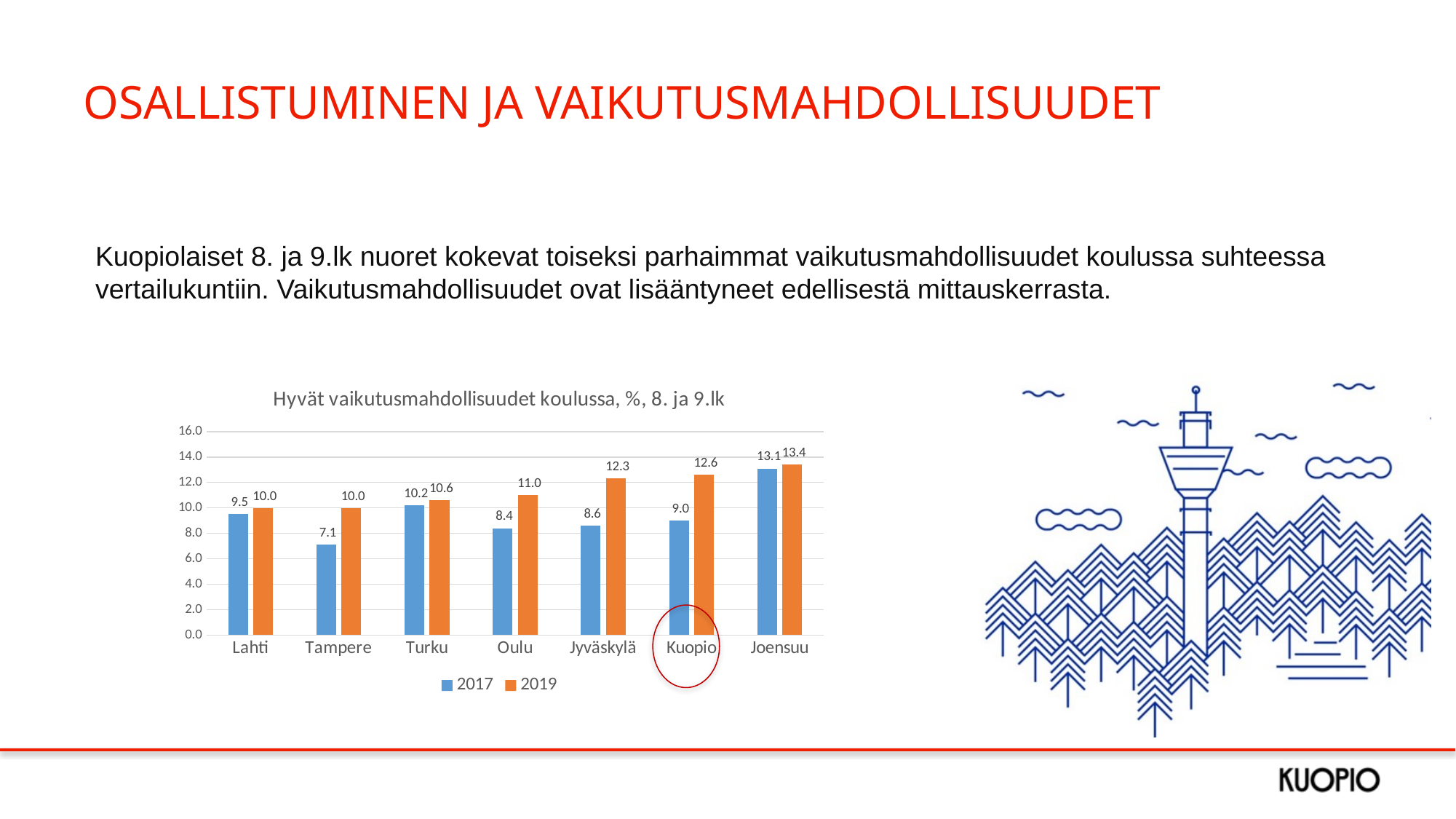
Which city has the lowest 2017 value? Tampere What is the 2017 value for Tampere? 7.1 What is the 2019 value for Oulu? 11.0 Which city has the highest 2019 value? Joensuu What kind of chart is shown? Bar chart What is the title of the chart? Hyvät vaikutusmahdollisuudet koulussa, %, 8. ja 9.lk How many series does the legend list? 2 Which is larger, the 2019 value for Jyväskylä or the 2019 value for Turku? Jyväskylä What is the difference between the 2019 and 2017 values for Kuopio? 3.6 What is the difference between the 2019 values for Joensuu and Lahti? 3.4 How many cities are shown on the x axis? 7 What is the 2019 value for Kuopio? 12.6